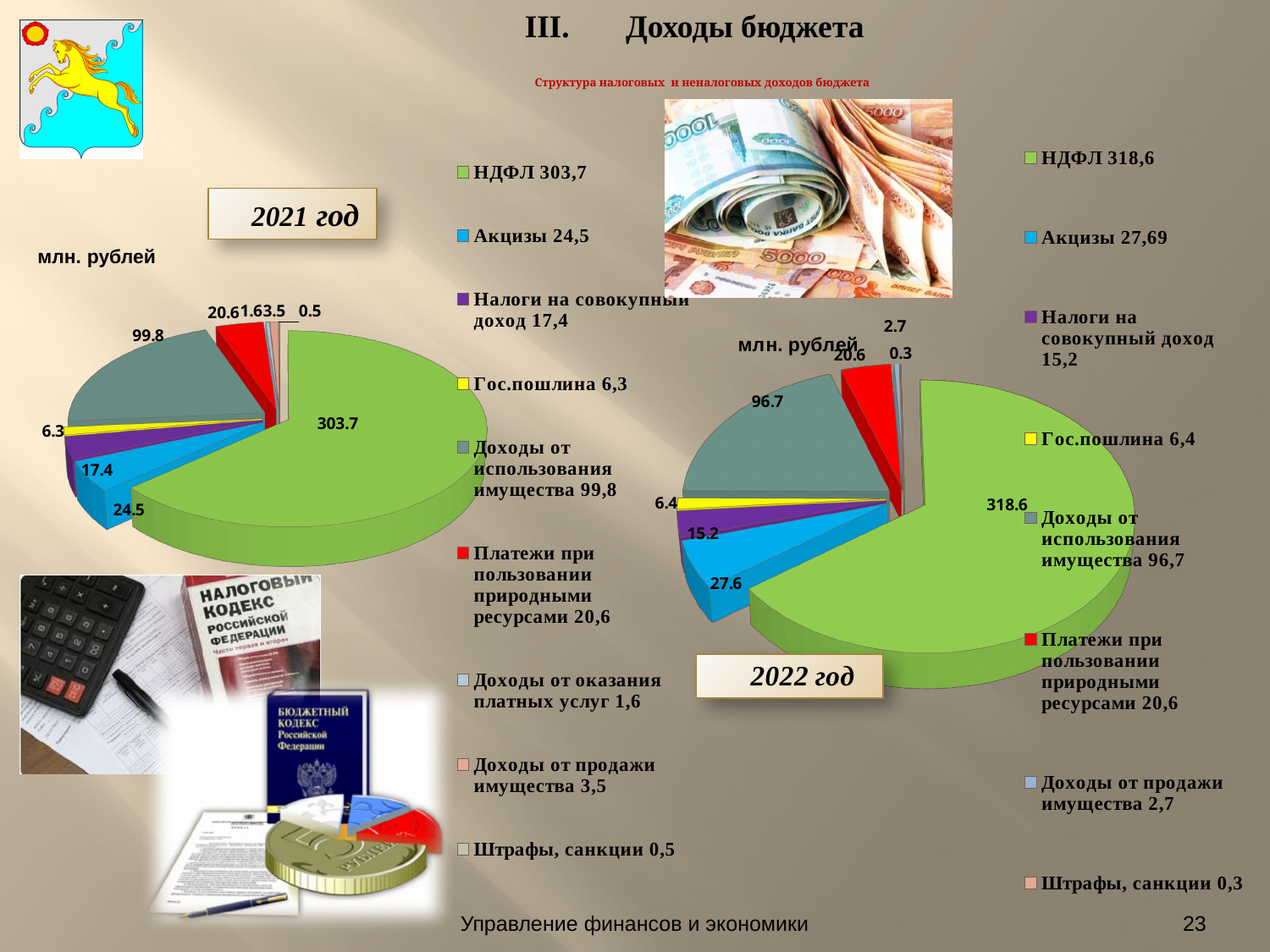
In the 2022 год chart, what is the value for Гос.пошлина? 6.4 How many categories does the legend of the 2021 год chart list? 9 In the 2022 год chart, which category has the largest slice? НДФЛ In the 2021 год chart, what is the difference between НДФЛ (303.7) and Доходы от использования имущества (99.8)? 203.9 In the 2021 год chart, which category has the smallest value? Штрафы, санкции In the 2021 год chart, what is the value for Акцизы? 24.5 How many categories does the legend of the 2022 год chart list? 8 Which is larger: Налоги на совокупный доход in the 2021 год chart or in the 2022 год chart? 2021 год (17.4) In the 2021 год chart, what is the value for НДФЛ? 303.7 In the 2022 год chart, what is the value for Доходы от использования имущества? 96.7 What type of chart is used for the 2021 год chart? pie chart What unit is stated for the values in both pie charts? млн. рублей